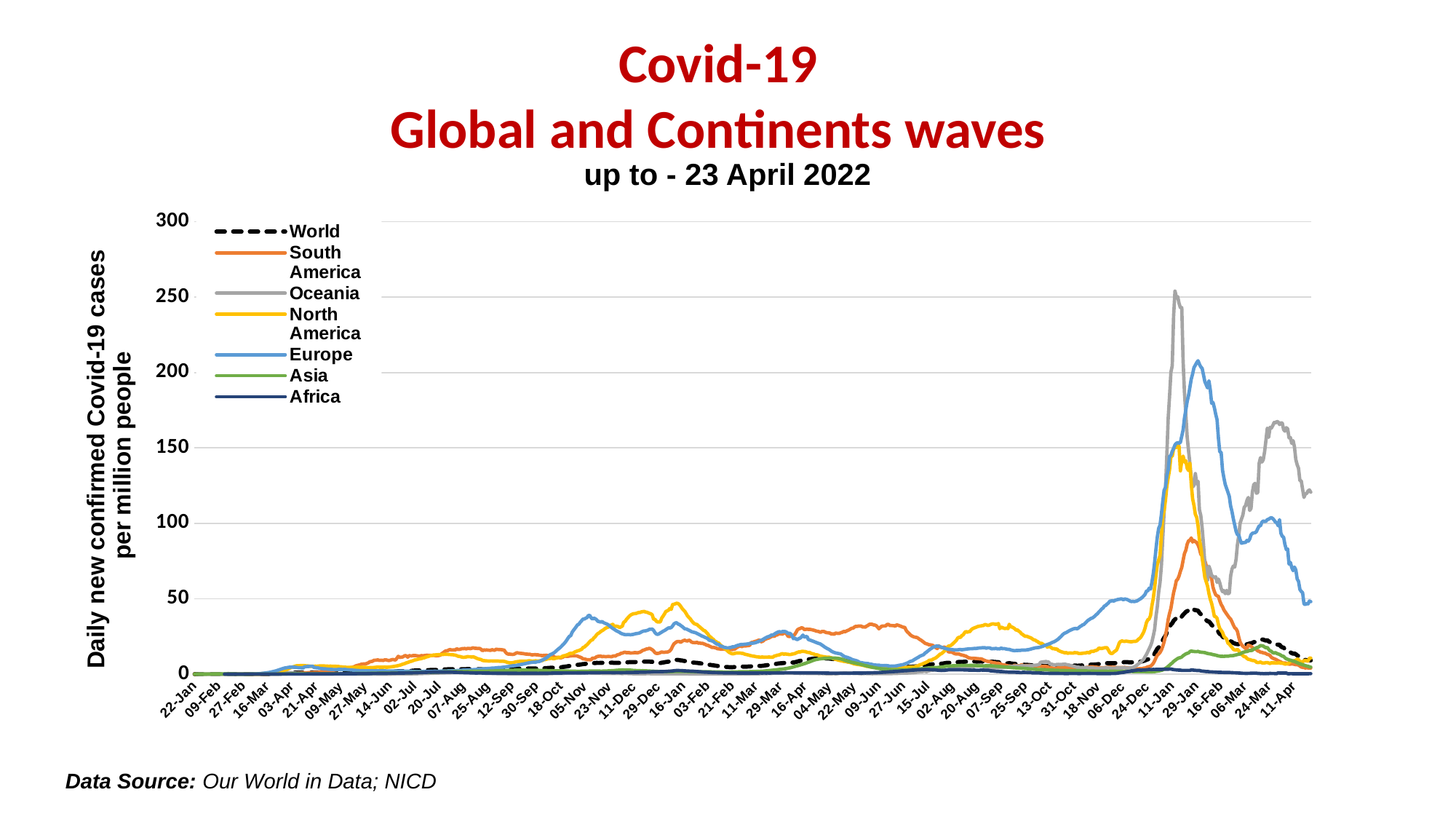
Is the peak value for North America greater or less than 100? greater Is the peak value for Europe greater or less than 150? greater Which series is drawn as a dashed line? World Is the peak value for Oceania greater or less than 200? greater Which series stays lowest across the whole chart? Africa How many series does the legend list? 7 What is the label on the vertical axis? Daily new confirmed Covid-19 cases per million people What kind of chart is shown on the slide? Line chart Which series has the higher peak, Oceania or Europe? Oceania Which series reaches the highest peak on the chart? Oceania